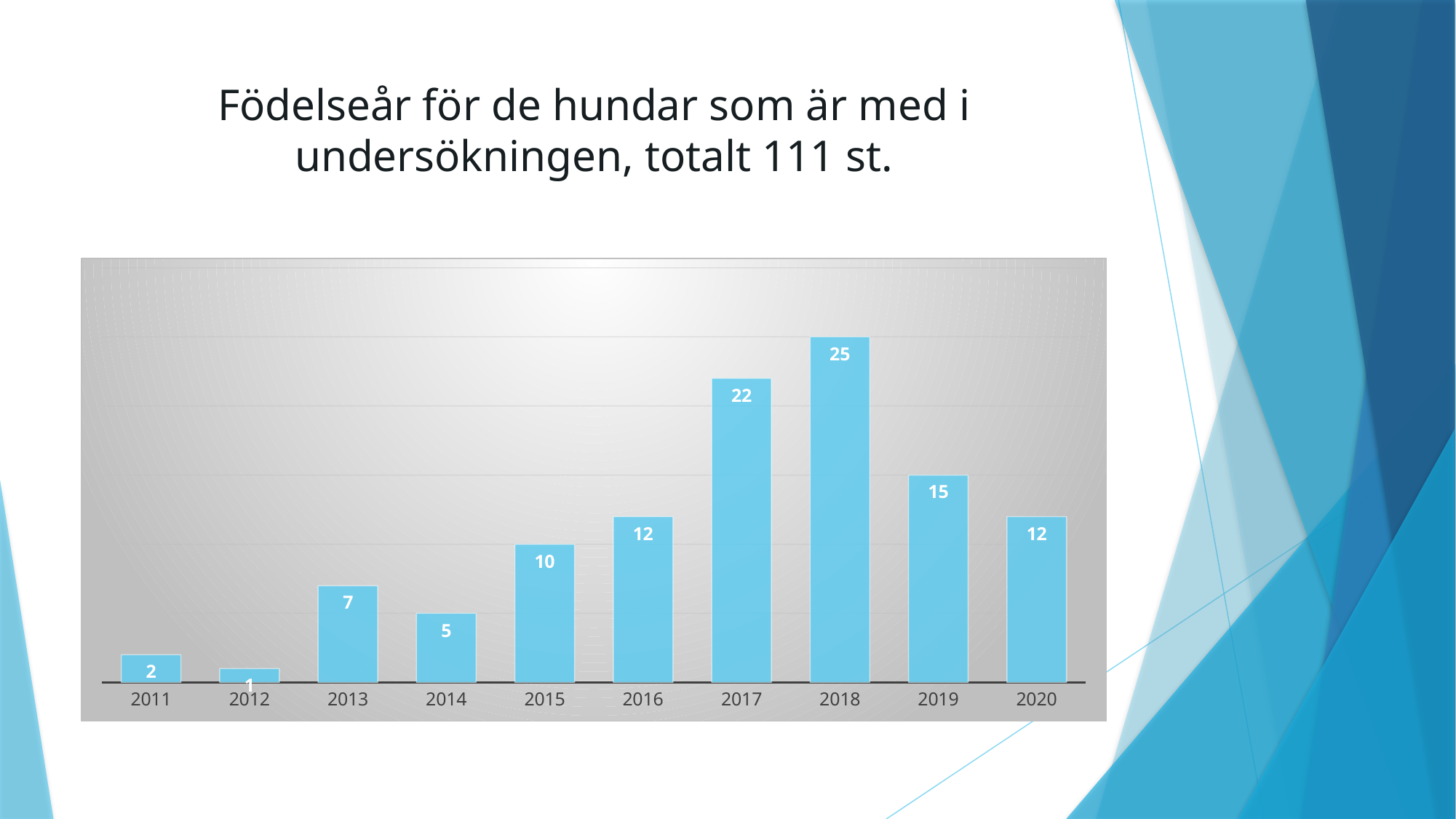
Which is larger, the value for 2013 or the value for 2014? 2013 Which year has the lowest value? 2012 What is the value for 2015? 10 How many years are shown on the x axis? 10 What is the difference between the values for 2019 and 2014? 10 What type of chart is shown on the slide? bar chart What is the difference between the values for 2018 and 2017? 3 What is the title of the slide? Födelseår för de hundar som är med i undersökningen, totalt 111 st. Do the values generally rise or fall from 2011 to 2018? rise Which year has the highest value? 2018 What is the value for 2020? 12 How many dogs in the survey were born in 2018? 25